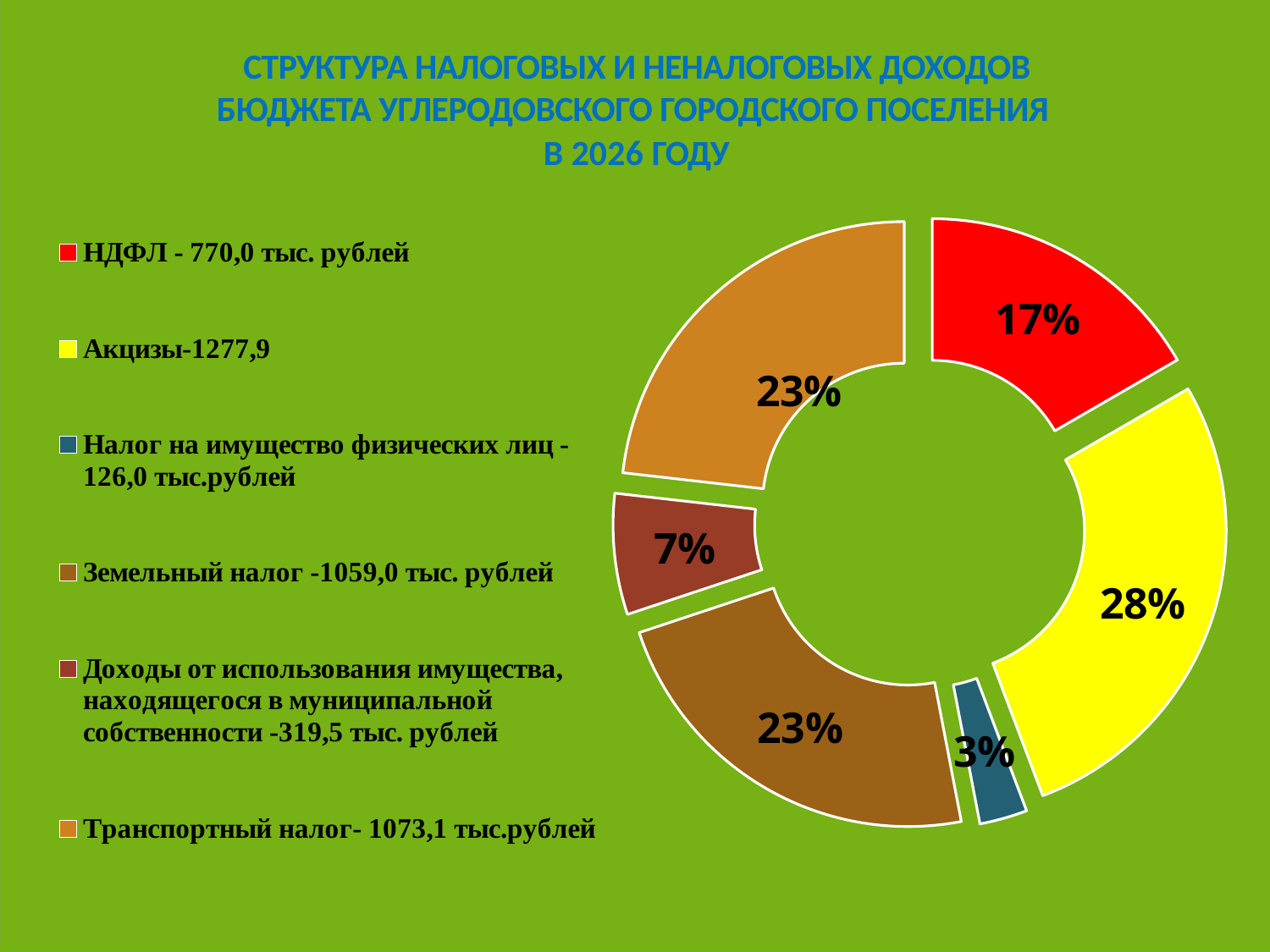
What is the difference in percentage points between the shares of Акцизы and НДФЛ? 11 percentage points What share of the chart does Доходы от использования имущества, находящегося в муниципальной собственности account for? 7% How many categories does the chart show? 6 Which category has the smallest share of the chart? Налог на имущество физических лиц What kind of chart is shown on the slide? Doughnut (pie) chart What share of the chart does Налог на имущество физических лиц account for? 3% What share of the chart does НДФЛ account for? 17% Which has the larger share, Земельный налог or Доходы от использования имущества, находящегося в муниципальной собственности? Земельный налог According to the legend, what is the amount for Транспортный налог? 1073,1 тыс.рублей Which category has the largest share of the chart? Акцизы Which colour represents НДФЛ in the chart? Red